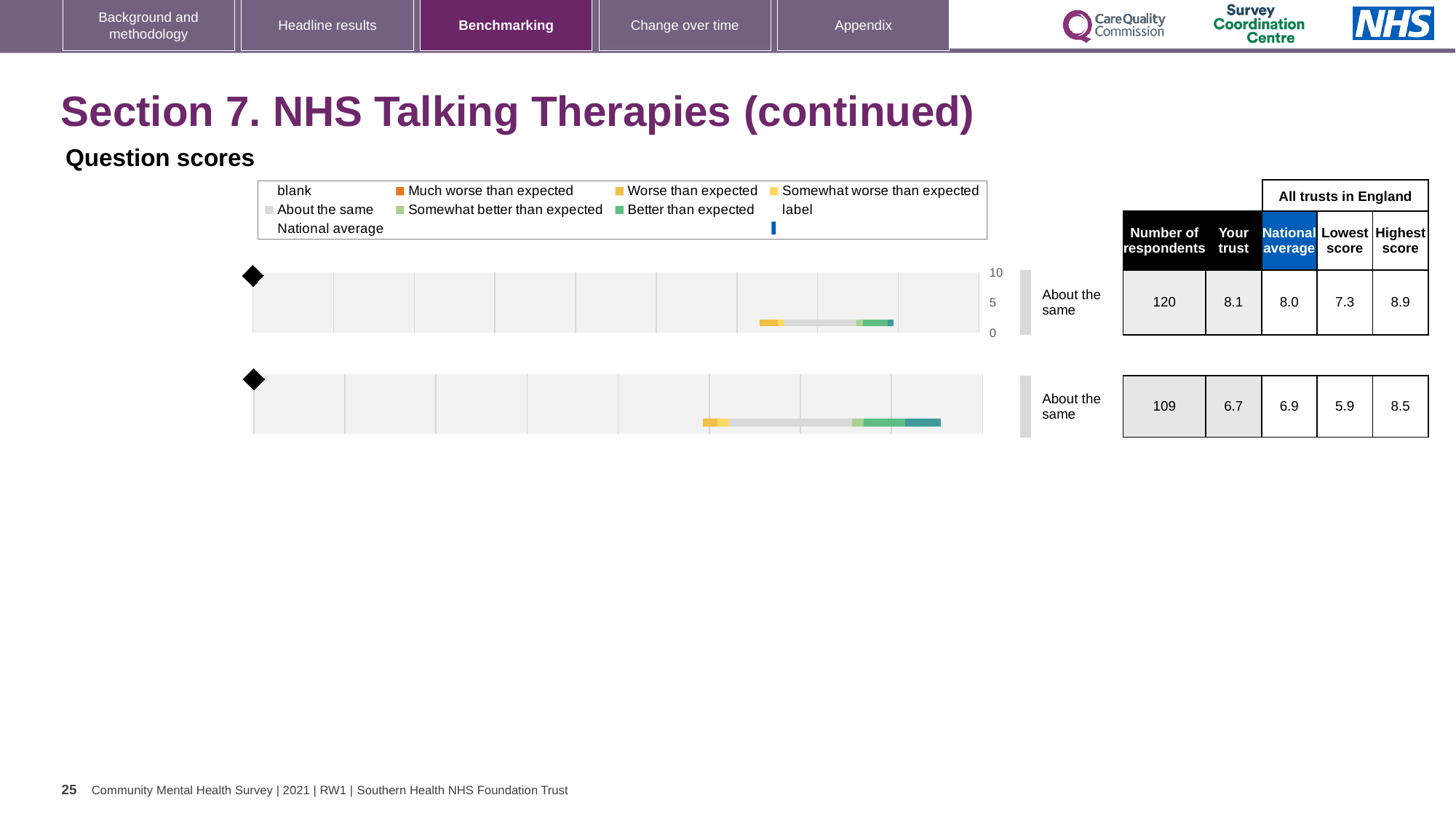
How many question score charts (rows) are shown on the slide? 2 For the top chart row, what is the difference between the highest score and the lowest score? 1.6 For the top chart row, how many respondents are listed? 120 What benchmark category label is shown next to the bottom chart row? About the same What is the difference in the number of respondents between the top chart row and the bottom chart row? 11 For the bottom chart row, which is larger: the 'Your trust' score or the national average? National average What kind of chart is used to show the question scores on this slide? Bar chart For the bottom chart row, what is the lowest score among all trusts in England? 5.9 For the top chart row, what is the 'Your trust' score in the table? 8.1 For the top chart row, which is larger: the 'Your trust' score or the national average? Your trust For the bottom chart row, what is the national average score? 6.9